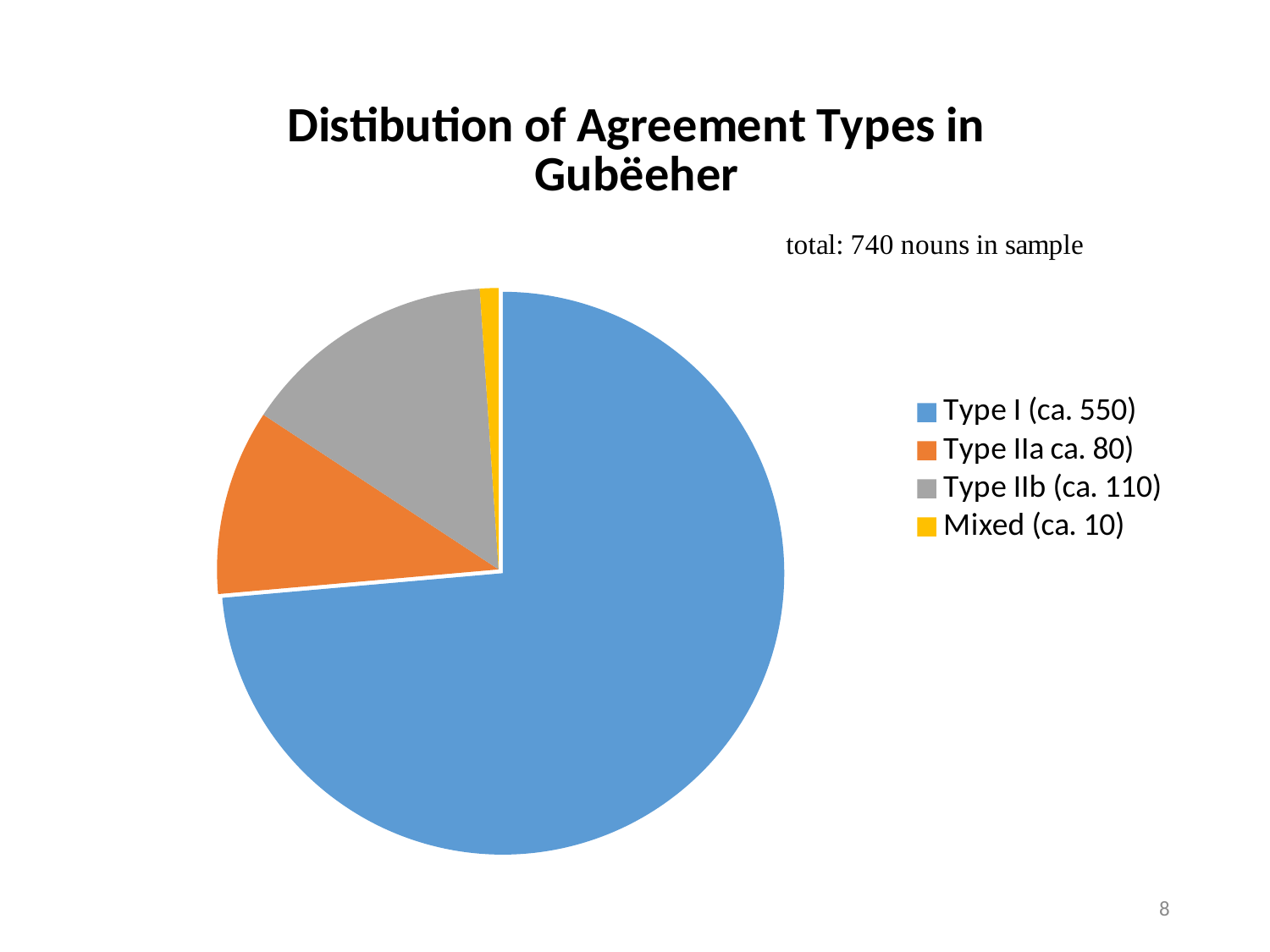
What value does the legend give for Type I? ca. 550 Which slice is larger, Type I or Type IIb? Type I What kind of chart is shown on the slide? pie chart What value does the legend give for Type IIb? ca. 110 Which agreement type has the smallest slice of the pie? Mixed According to the slide, how many nouns are in the sample in total? 740 What value does the legend give for Mixed? ca. 10 Which slice is larger, Type IIa or Type IIb? Type IIb Which agreement type has the largest slice of the pie? Type I What is the title of the chart? Distibution of Agreement Types in Gubëeher How many slices does the pie chart have? 4 How many entries does the legend list? 4